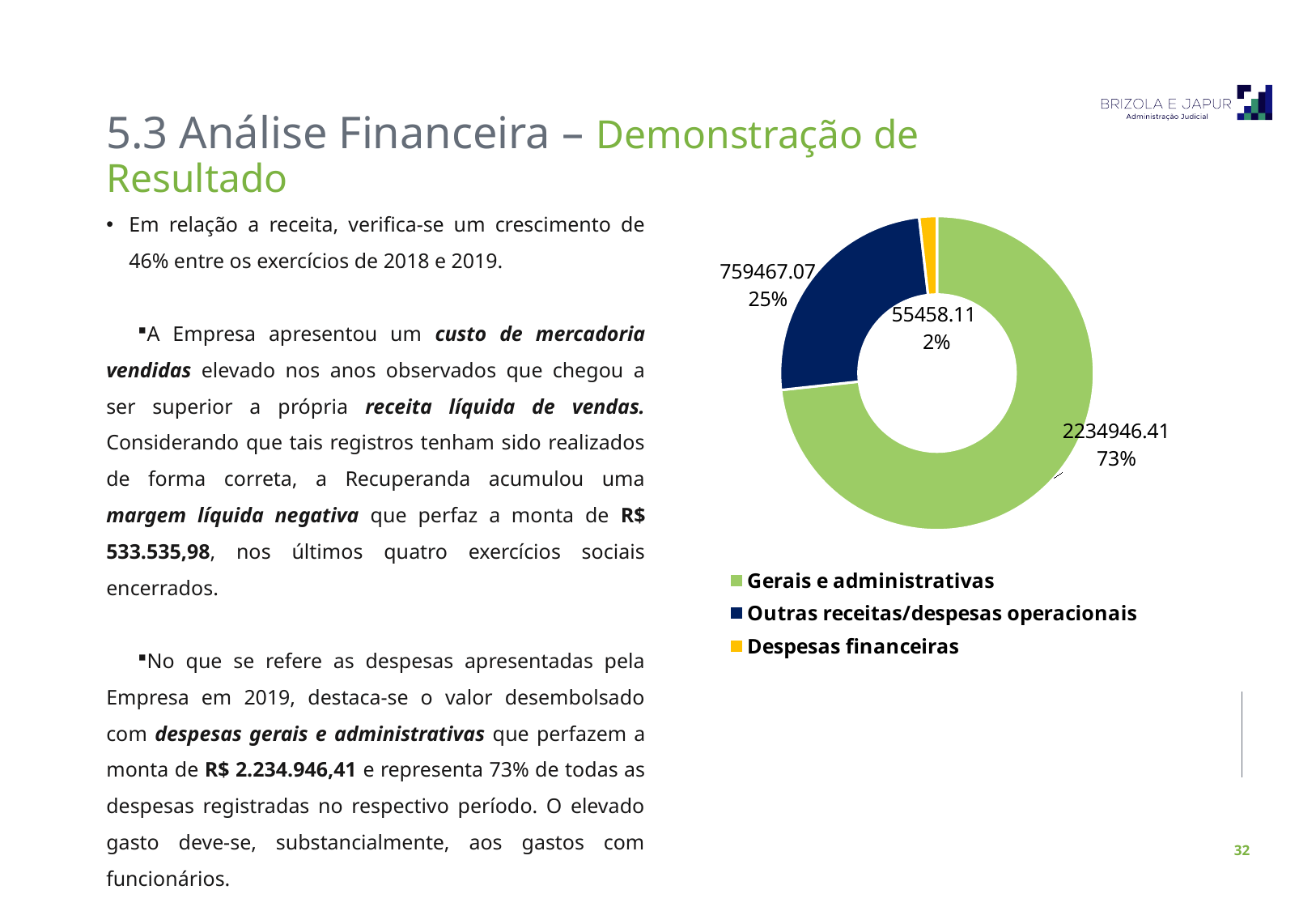
Which is larger, Outras receitas/despesas operacionais or Despesas financeiras? Outras receitas/despesas operacionais What is the value shown for Despesas financeiras? 55458.11 What share of the chart does Despesas financeiras represent? 2% Which category has the largest slice? Gerais e administrativas How many categories does the chart show? 3 What kind of chart is shown on the slide? doughnut chart What is the value shown for Outras receitas/despesas operacionais? 759467.07 What is the difference between the values for Gerais e administrativas and Outras receitas/despesas operacionais? 1475479.34 What is the value shown for Gerais e administrativas? 2234946.41 Which category has the smallest slice? Despesas financeiras What share of the chart does Gerais e administrativas represent? 73% What share of the chart does Outras receitas/despesas operacionais represent? 25%